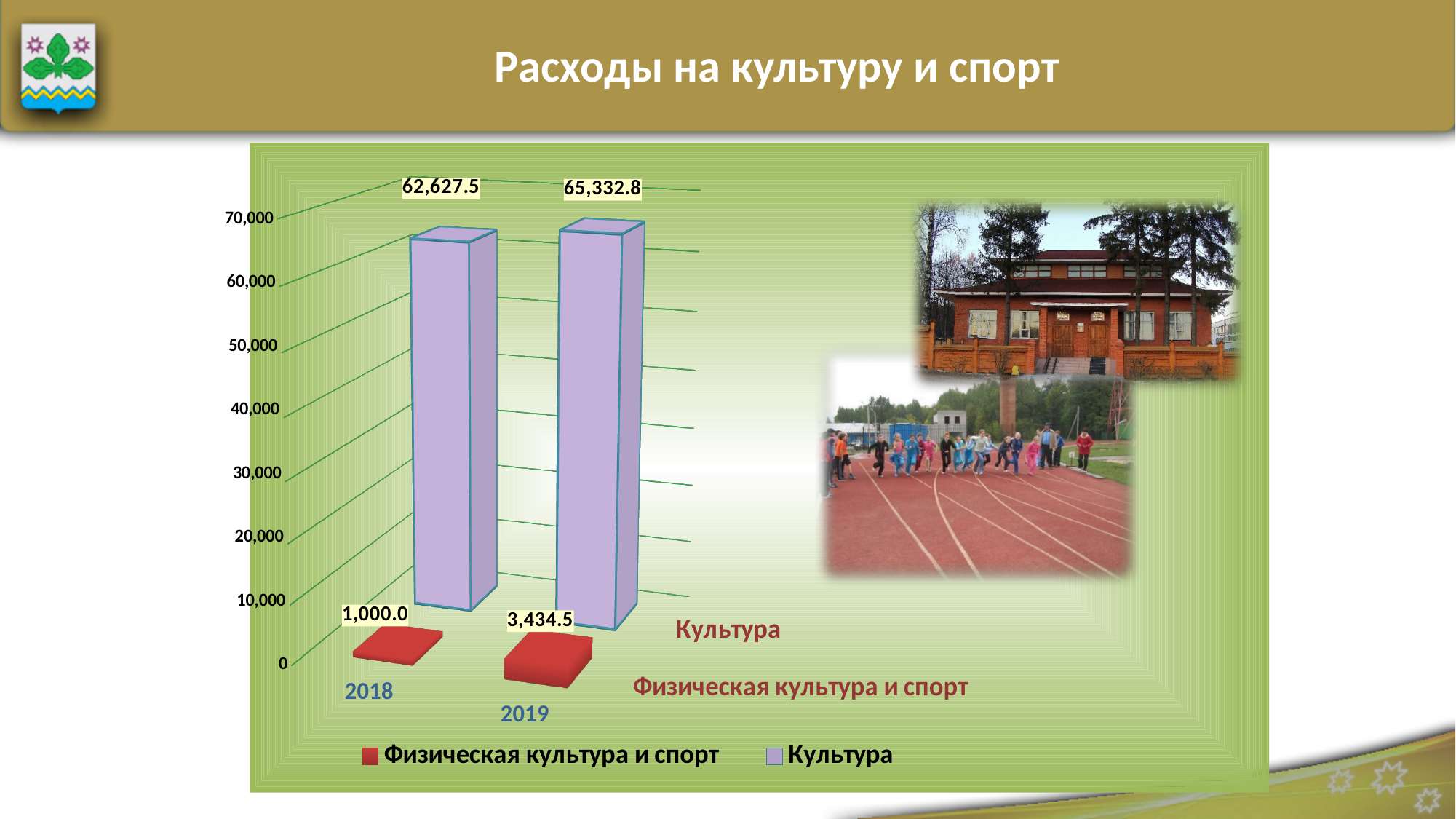
Which series has the lowest value in 2018? Физическая культура и спорт Does the value for Культура rise or fall from 2018 to 2019? rise What is the value for Культура in 2018? 62,627.5 What is the value for Физическая культура и спорт in 2019? 3,434.5 In which year is the value for Культура higher? 2019 What is the value for Физическая культура и спорт in 2018? 1,000.0 By how much did the value for Культура change from 2018 to 2019? 2,705.3 What is the value for Культура in 2019? 65,332.8 Which is larger: Физическая культура и спорт in 2019 or Физическая культура и спорт in 2018? Физическая культура и спорт in 2019 How many series does the legend list? 2 What is the difference between the 2019 and 2018 values for Физическая культура и спорт? 2,434.5 What is the title of the chart? Расходы на культуру и спорт